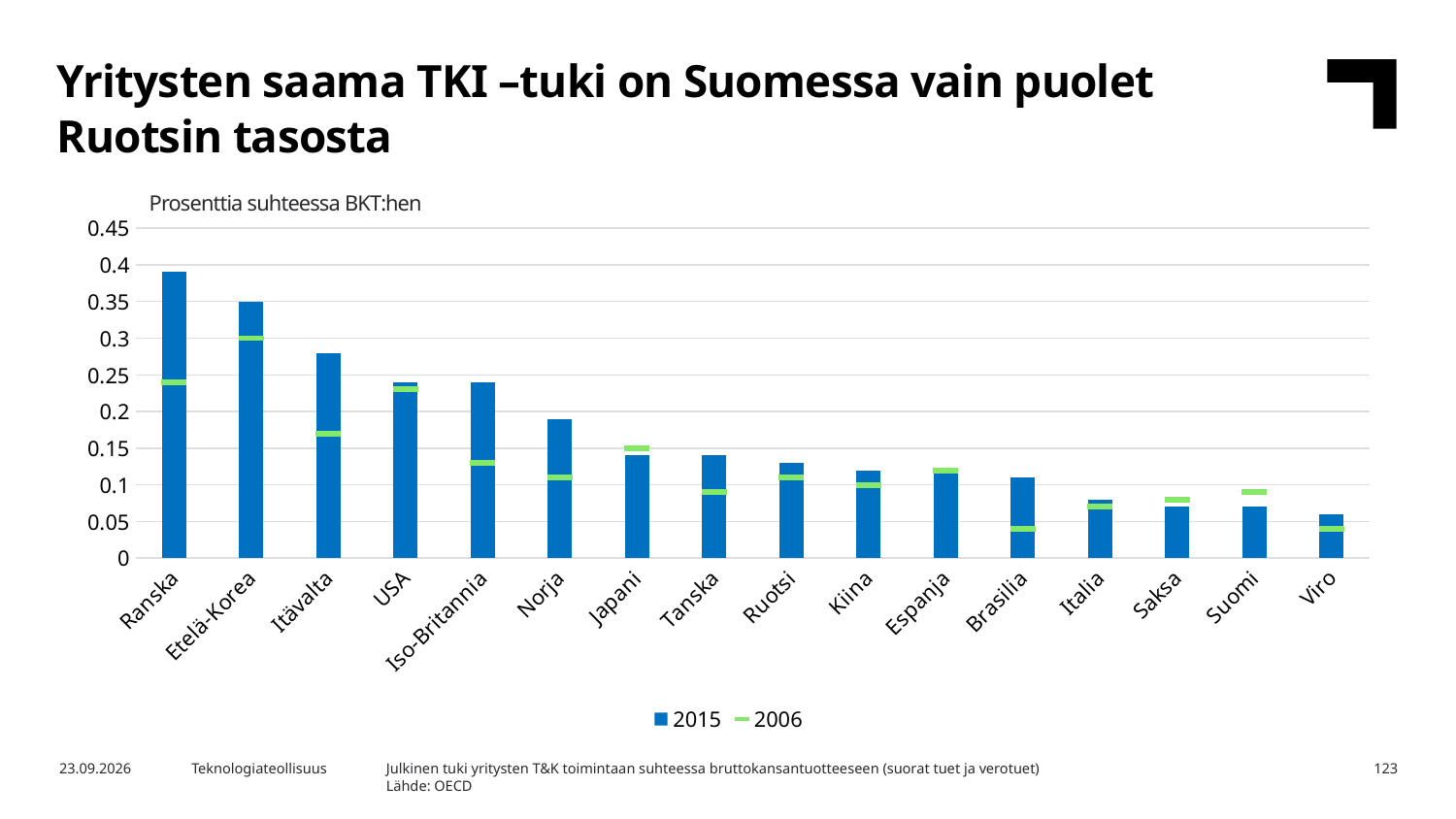
What kind of chart is shown on the slide? Bar chart Is the 2015 value for Ranska greater or less than 0.35? greater Which has the larger 2015 value, Ruotsi or Suomi? Ruotsi Which country has the highest 2015 value in the chart? Ranska How many countries are shown on the x axis of the chart? 16 How many series does the chart legend list? 2 Do the 2015 values rise or fall moving from left to right along the x axis? fall Is the 2015 value for Suomi greater or less than 0.1? less Is the 2015 value for Norja greater or less than 0.2? less Which country has the lowest 2015 value in the chart? Viro What are the two series named in the chart legend? 2015 and 2006